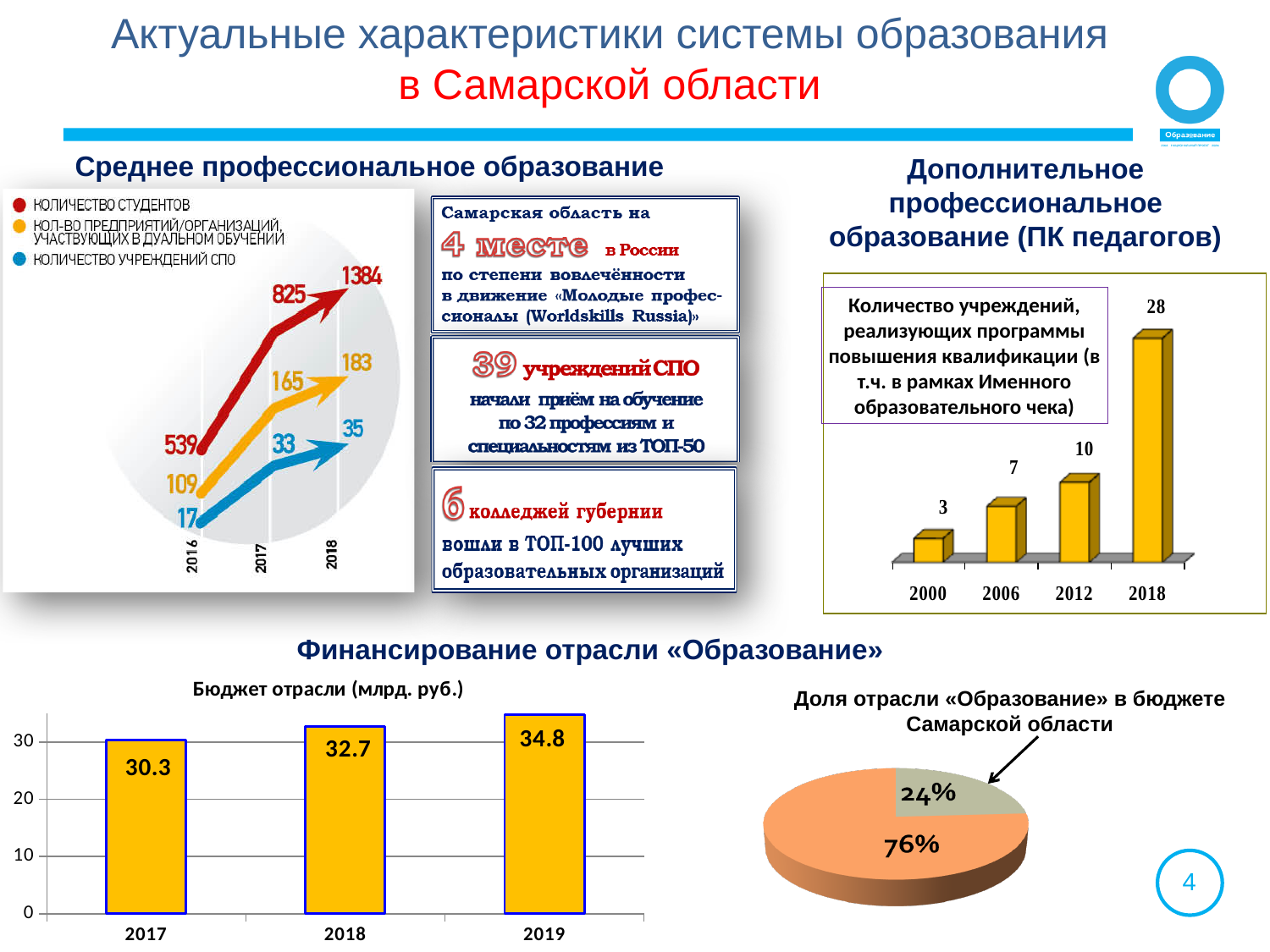
In the top-left chart under "Среднее профессиональное образование", how many series does the legend list? 3 In the pie chart "Доля отрасли «Образование» в бюджете Самарской области", what share does the education sector have? 24% In the chart "Количество учреждений, реализующих программы повышения квалификации", which year has the highest value? 2018 In the chart "Количество учреждений, реализующих программы повышения квалификации", what is the difference between the 2018 and 2006 values? 21 In the chart "Количество учреждений, реализующих программы повышения квалификации", which year has the lowest value? 2000 In the chart titled "Бюджет отрасли (млрд. руб.)", what is the value for 2017? 30.3 In the chart titled "Бюджет отрасли (млрд. руб.)", what is the difference between the 2019 and 2017 values? 4.5 In the chart titled "Бюджет отрасли (млрд. руб.)", do the values rise or fall from 2017 to 2019? rise In the top-left chart under "Среднее профессиональное образование", what is the value for "Количество студентов" in 2018? 1384 In the chart titled "Бюджет отрасли (млрд. руб.)", how many years are shown on the x axis? 3 In the chart titled "Бюджет отрасли (млрд. руб.)", what is the value for 2019? 34.8 In the chart "Количество учреждений, реализующих программы повышения квалификации", what is the value for 2012? 10